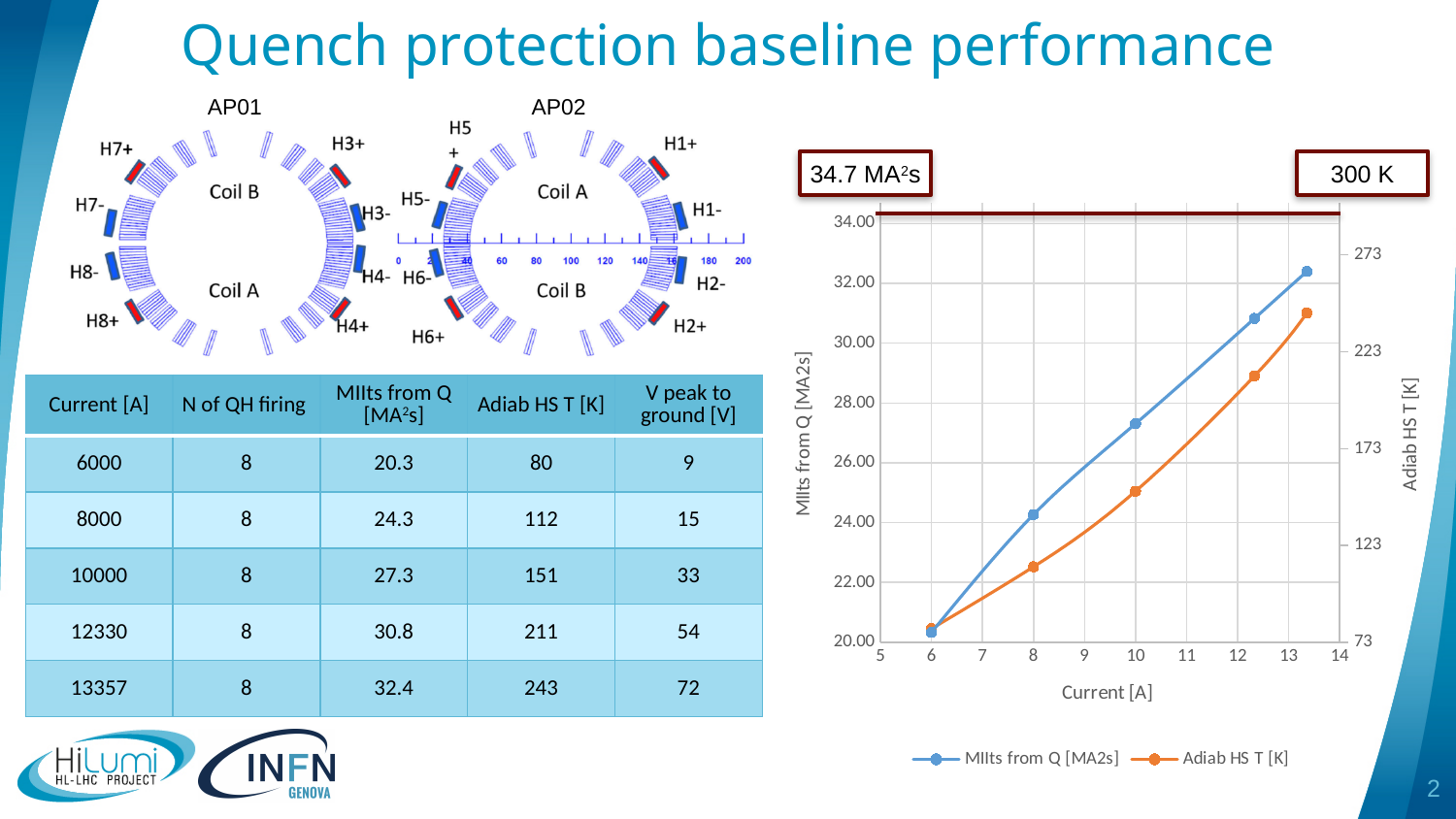
Is the MIIts from Q [MA2s] value at Current 8 greater or less than 26.00? less Do the MIIts from Q [MA2s] values rise or fall as Current increases along the x axis? rise Is the Adiab HS T [K] value at the highest plotted Current greater or less than 223 on the right axis? greater Do the Adiab HS T [K] values rise or fall as Current increases along the x axis? rise How many data points are plotted for the MIIts from Q [MA2s] series? 5 Is the MIIts from Q [MA2s] value at Current 10 greater or less than 26.00? greater What is the title of the x axis of the chart? Current [A] What kind of chart is shown on the right of the slide? line chart How many series does the chart legend list? 2 Which series is drawn in orange in the chart? Adiab HS T [K]